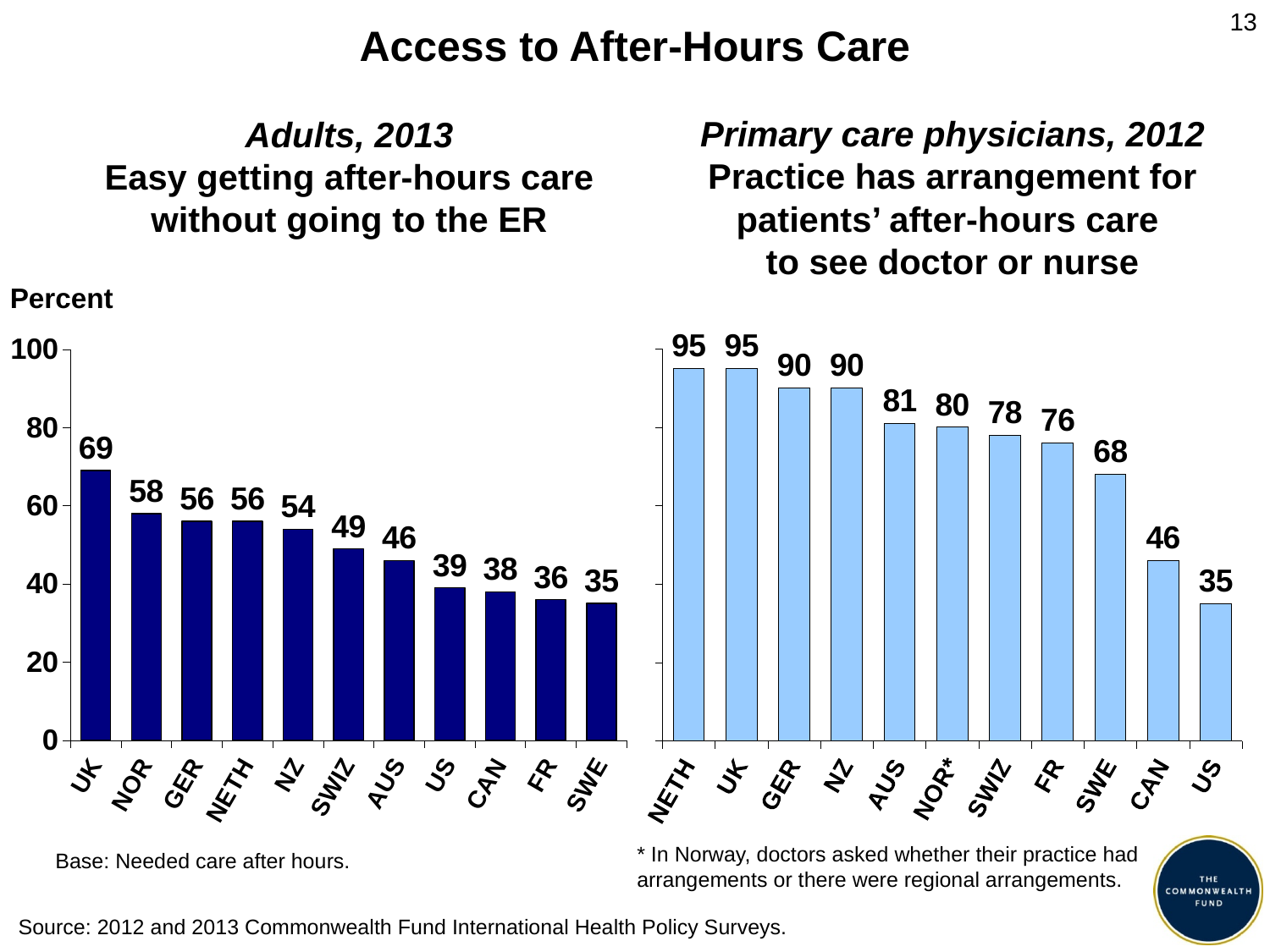
What kind of chart is the right chart (Primary care physicians, 2012)? bar chart In the right chart (Primary care physicians, 2012), which country has the lowest value? US How many countries are shown in the left chart (Adults, 2013)? 11 In the right chart (Primary care physicians, 2012), do the values rise or fall from left to right? fall In the left chart (Adults, 2013), what is the difference between the values for UK and US? 30 In the left chart (Adults, 2013), is the value for NZ greater or less than 40? greater In the left chart (Adults, 2013), which country has the lowest value? SWE In the left chart (Adults, 2013), which country has the highest value? UK In the right chart (Primary care physicians, 2012), what is the difference between the values for NETH and CAN? 49 In the left chart (Adults, 2013), what is the value for the UK? 69 In the right chart (Primary care physicians, 2012), which is larger, the value for AUS or the value for FR? AUS In the right chart (Primary care physicians, 2012), what is the value for SWE? 68